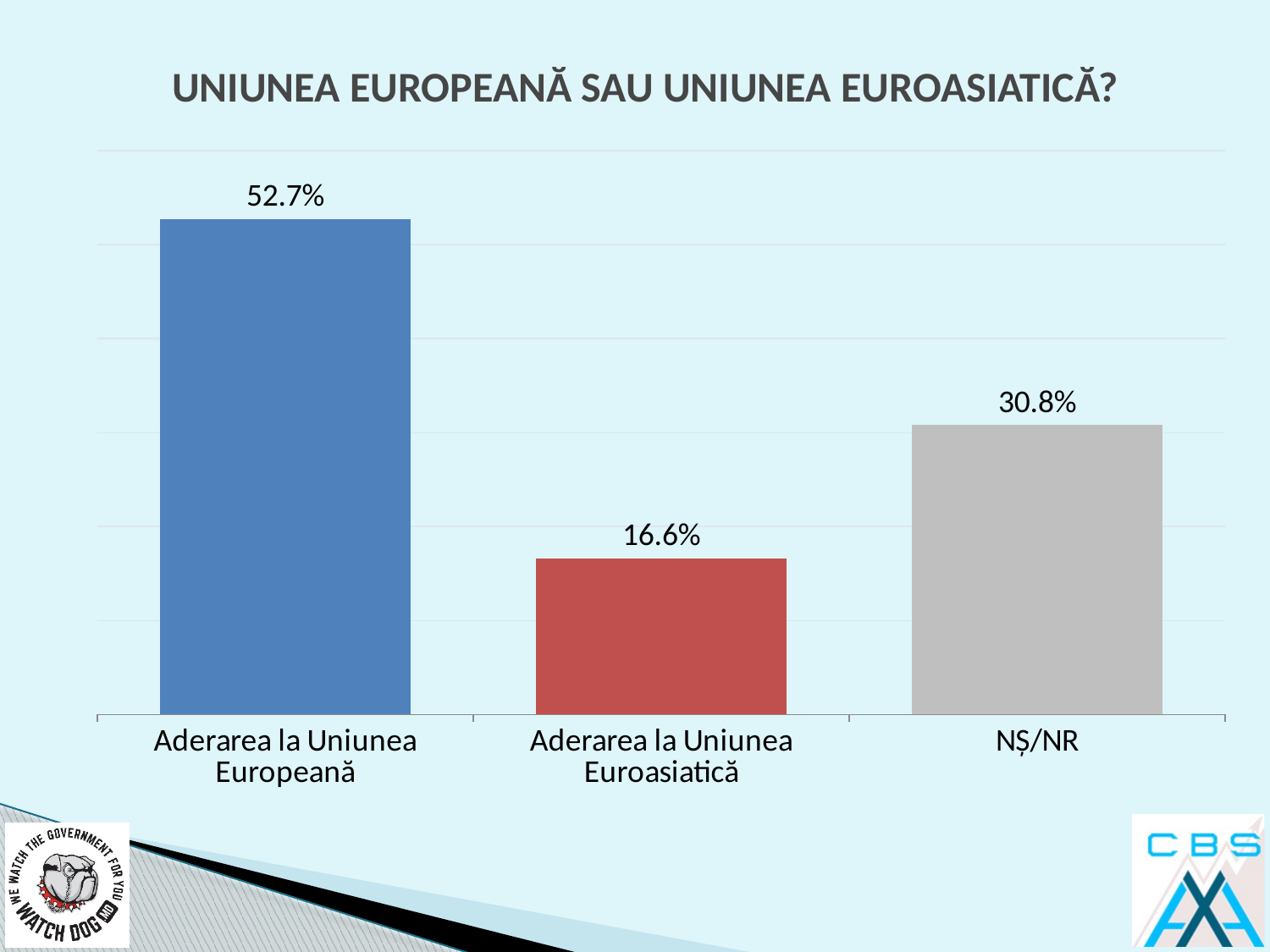
What kind of chart is shown on the slide? Bar chart Which category has the lowest value? Aderarea la Uniunea Euroasiatică What is the difference between the values for NȘ/NR and Aderarea la Uniunea Euroasiatică? 14.2% What colour is the bar for Aderarea la Uniunea Euroasiatică? Red What is the value for NȘ/NR? 30.8% Which is larger, the value for NȘ/NR or the value for Aderarea la Uniunea Euroasiatică? NȘ/NR Which category has the highest value? Aderarea la Uniunea Europeană What is the value for Aderarea la Uniunea Euroasiatică? 16.6% What is the difference between the values for Aderarea la Uniunea Europeană and Aderarea la Uniunea Euroasiatică? 36.1% What is the value for Aderarea la Uniunea Europeană? 52.7% What is the title of the chart? UNIUNEA EUROPEANĂ SAU UNIUNEA EUROASIATICĂ? How many categories are shown in the chart? 3